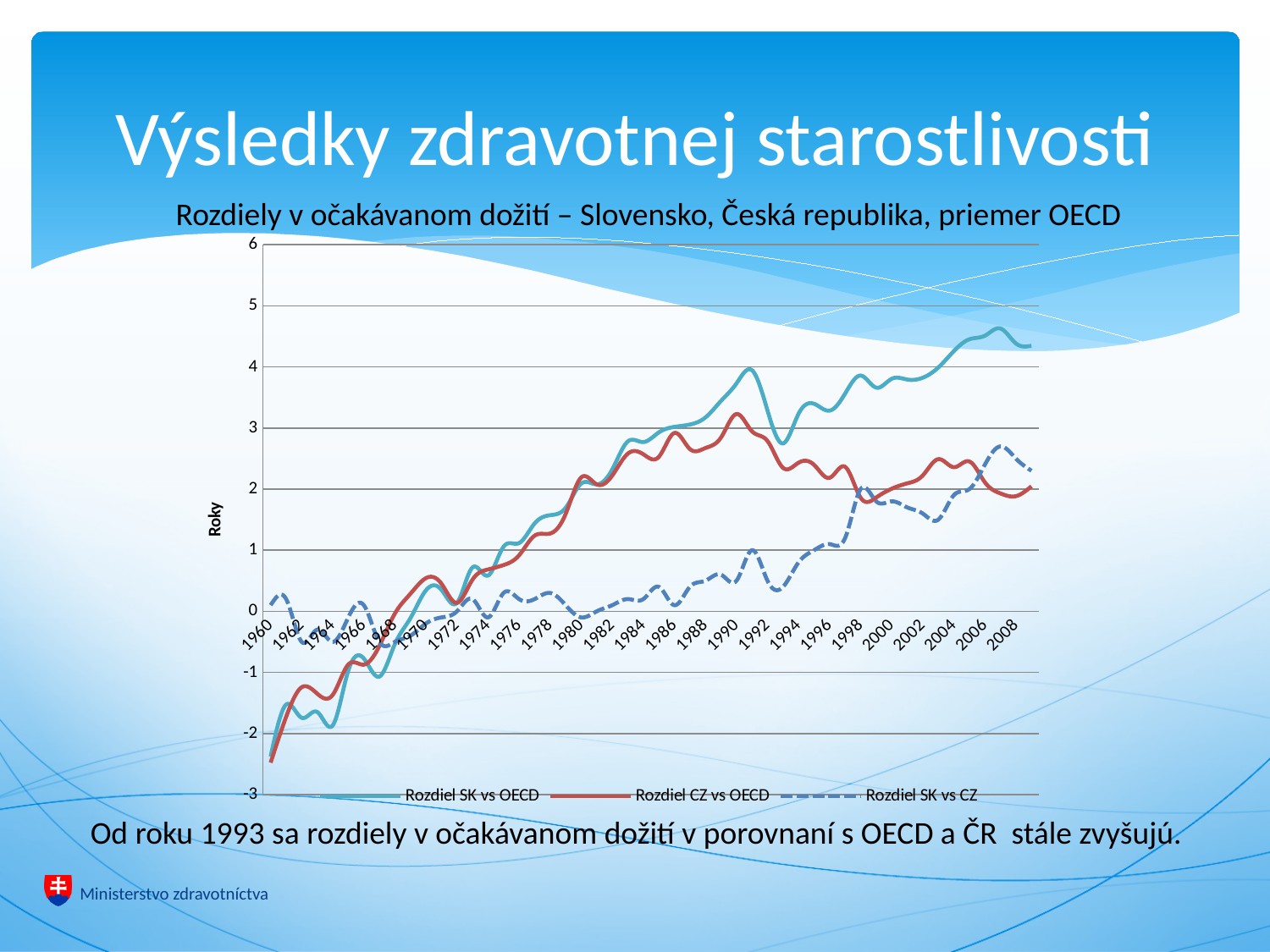
Is the value of Rozdiel CZ vs OECD in 1960 greater or less than -2? less How many series does the chart legend list? 3 Is the value of Rozdiel SK vs OECD in 2006 greater or less than 4? greater Is the value of Rozdiel SK vs CZ in 2006 greater or less than 2? greater What kind of chart is shown on the slide? line chart Which series has the highest value at the end of the chart (2008)? Rozdiel SK vs OECD What are the three series named in the chart legend? Rozdiel SK vs OECD, Rozdiel CZ vs OECD, Rozdiel SK vs CZ What is the label of the vertical axis of the chart? Roky Does the Rozdiel SK vs OECD series generally rise or fall from 1960 to 2008? rise In 1990, which series has the larger value: Rozdiel SK vs OECD or Rozdiel CZ vs OECD? Rozdiel SK vs OECD In 2008, which series has the larger value: Rozdiel SK vs OECD or Rozdiel CZ vs OECD? Rozdiel SK vs OECD